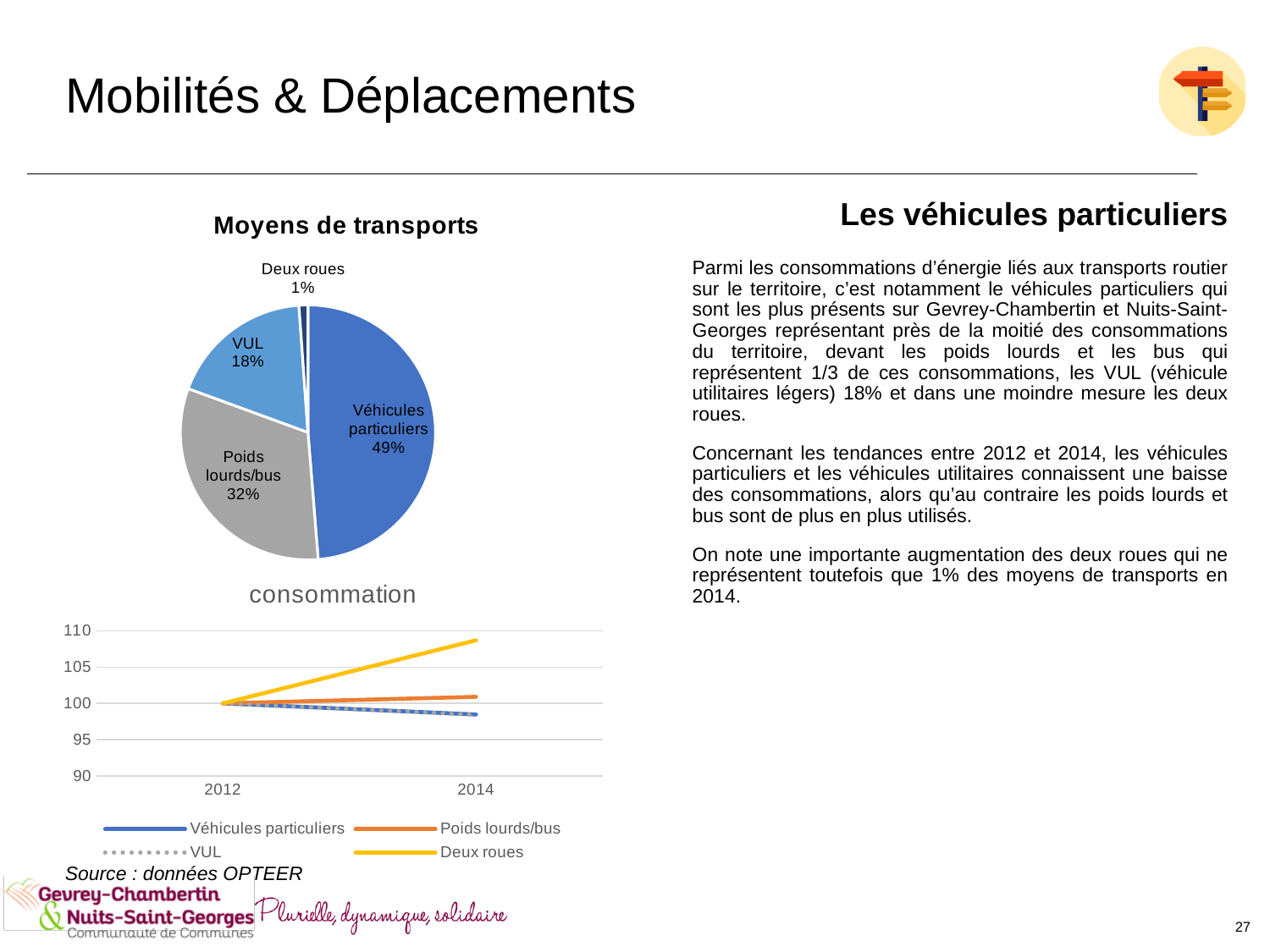
In the 'consommation' line chart, how many series does the legend list? 4 In the 'Moyens de transports' pie chart, what share is shown for Poids lourds/bus? 32% In the 'Moyens de transports' pie chart, what share is shown for VUL? 18% In the 'consommation' line chart, is the value for Deux roues in 2014 greater or less than 105? greater In the 'Moyens de transports' pie chart, which category has the smallest share? Deux roues In the 'consommation' line chart, which series has the higher value in 2014: Deux roues or Véhicules particuliers? Deux roues In the 'consommation' line chart, does the Deux roues line rise or fall from 2012 to 2014? Rises In the 'Moyens de transports' pie chart, how many categories are shown? 4 In the 'Moyens de transports' pie chart, which category has the largest share? Véhicules particuliers In the 'Moyens de transports' pie chart, what share is shown for Véhicules particuliers? 49% In the 'Moyens de transports' pie chart, what is the difference in percentage points between Véhicules particuliers and Poids lourds/bus? 17 What kind of chart is the 'consommation' chart at the bottom left of the slide? Line chart